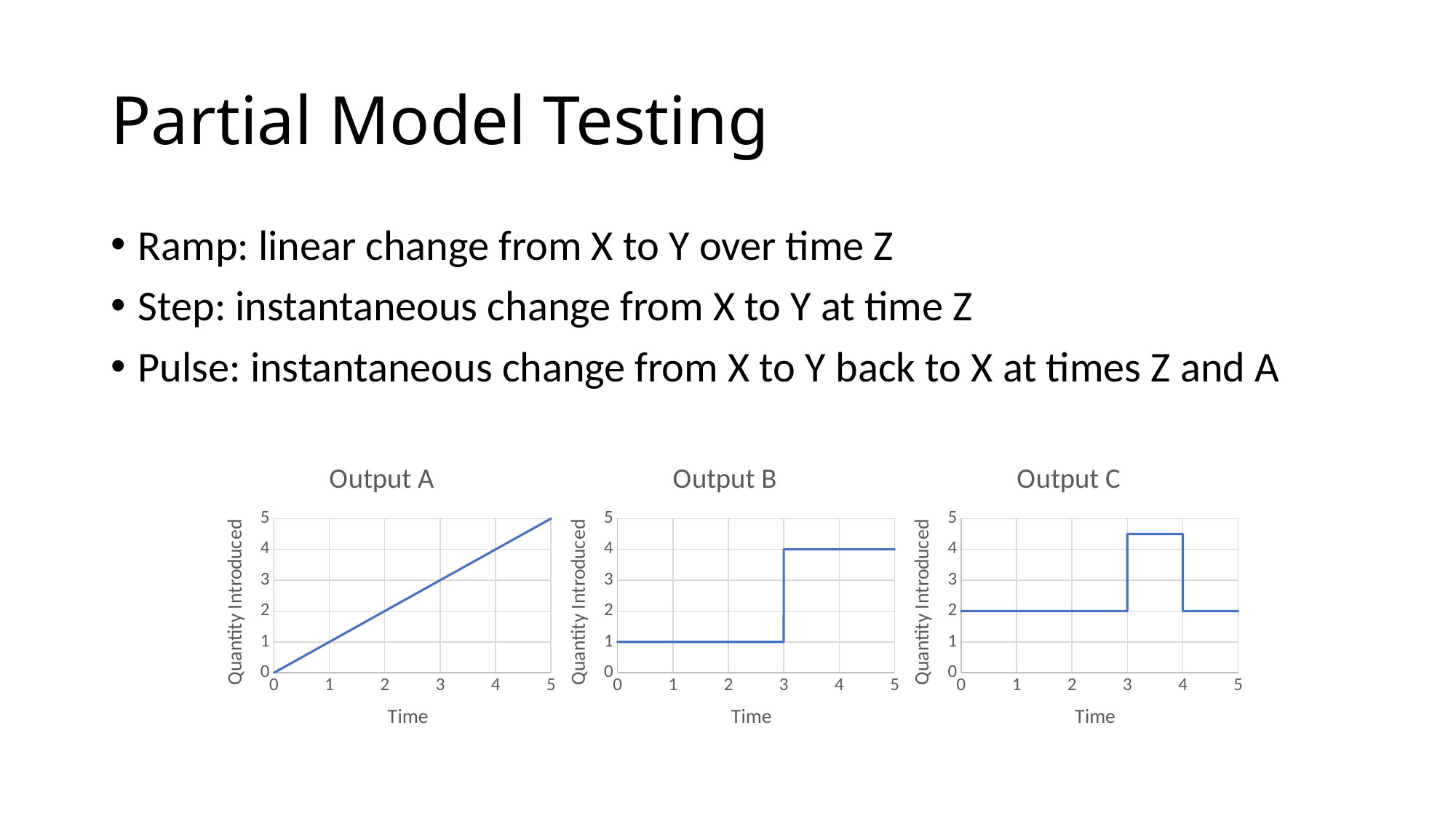
In the Output B chart, what is the difference between the value at Time 4 and the value at Time 1? 3 In the Output C chart, which is larger, the value at Time 3.5 or the value at Time 5? the value at Time 3.5 In the Output C chart, what is the value of Quantity Introduced at Time 1? 2 In the Output B chart, what is the value of Quantity Introduced at Time 1? 1 In the Output B chart, what is the value of Quantity Introduced at Time 4? 4 In the Output A chart, do the values rise or fall as Time increases? rise What kind of chart is Output A? line chart What is the label of the y axis on the Output B chart? Quantity Introduced In the Output A chart, what is the value of Quantity Introduced at Time 0? 0 In the Output C chart, is the value at Time 3.5 greater or less than 4? greater How many charts are shown on the slide? 3 In the Output A chart, what is the value of Quantity Introduced at Time 5? 5